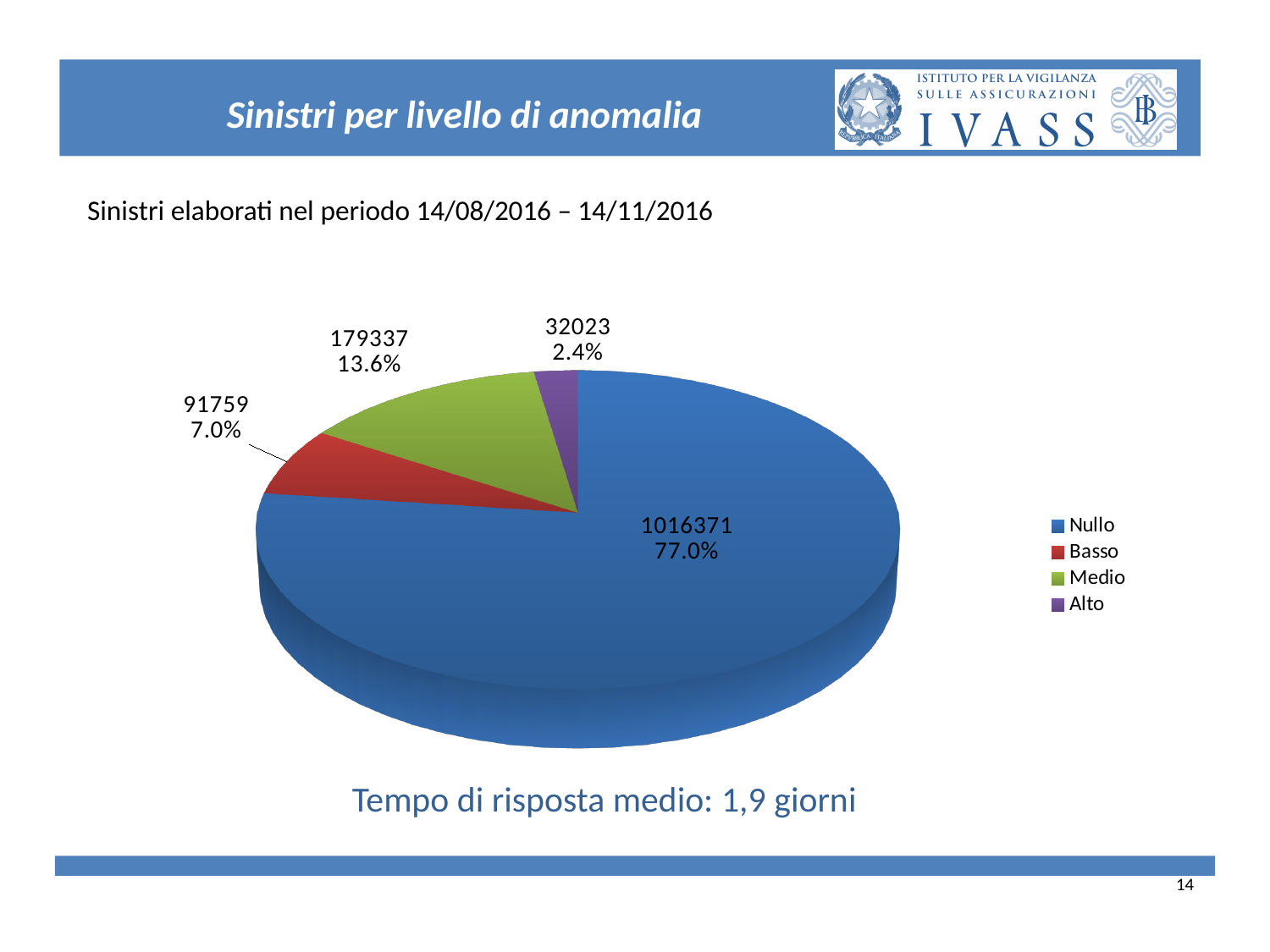
Which is larger, Basso or Medio? Medio What share of the pie does Alto represent? 2.4% What kind of chart is shown on the slide? pie chart How many slices does the pie chart have? 4 Which category has the smallest slice? Alto What is the value for Medio? 179337 What is the value for Basso? 91759 How many entries does the legend list? 4 What is the value for Nullo? 1016371 What is the value for Alto? 32023 Which category has the largest slice? Nullo What share of the pie does Medio represent? 13.6%